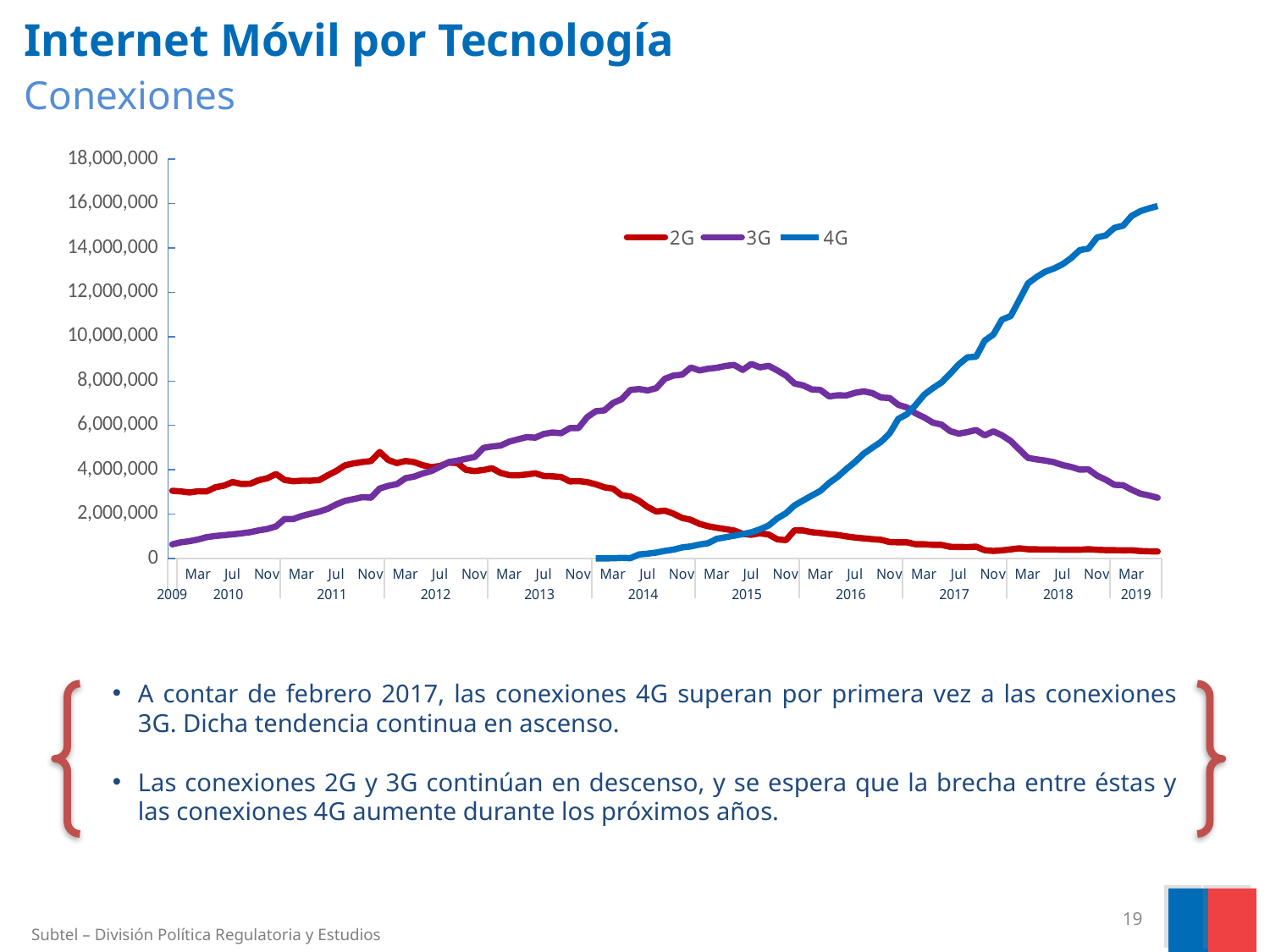
Is the value for 2G at the end of the chart (Mar 2019) greater or less than 2,000,000? less Is the value for 3G at the end of the chart (Mar 2019) greater or less than 4,000,000? less What kind of chart is shown on the slide? line chart Does the 4G line rise or fall from 2014 to 2019? rise At the start of the chart in 2009, which is larger: 2G or 3G? 2G How many series does the chart legend list? 3 Is the peak value of the 3G line (around 2015) greater or less than 8,000,000? greater Which series has the lowest value at the end of the chart (Mar 2019)? 2G Which series are listed in the chart legend? 2G, 3G, 4G Which series has the highest value at the end of the chart (Mar 2019)? 4G What colour is the 4G line in the chart? blue